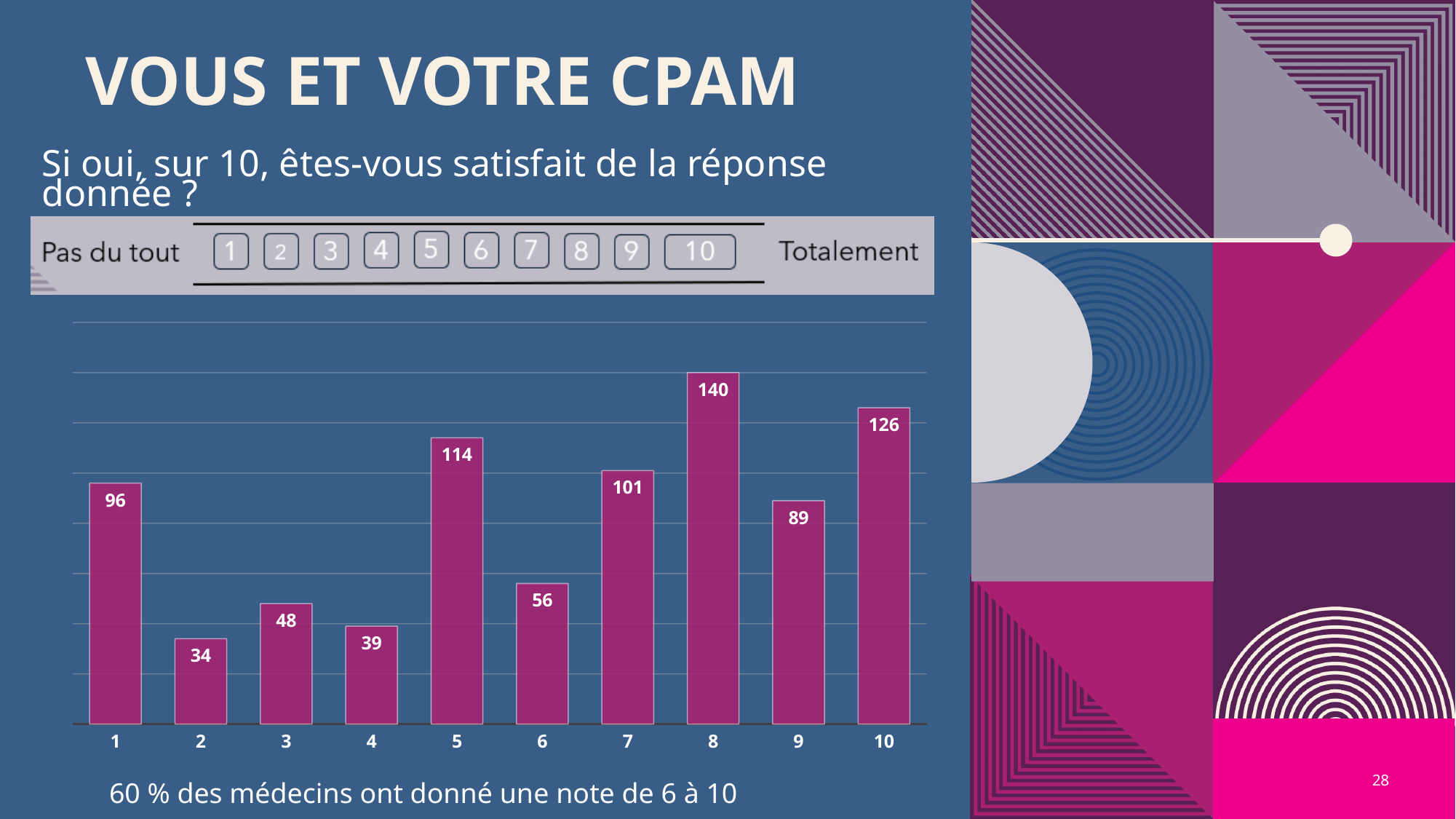
What is the value for category 2? 34 What kind of chart is shown on the slide? bar chart Which is larger, the value for category 3 or the value for category 4? 3 What is the value for category 6? 56 Which category has the highest value? 8 What is the difference between the values for category 1 and category 2? 62 Which category has the lowest value? 2 Which is larger, the value for category 7 or the value for category 9? 7 What is the value for category 8? 140 How many categories are shown on the x axis? 10 What is the value for category 5? 114 What is the difference between the values for category 8 and category 10? 14